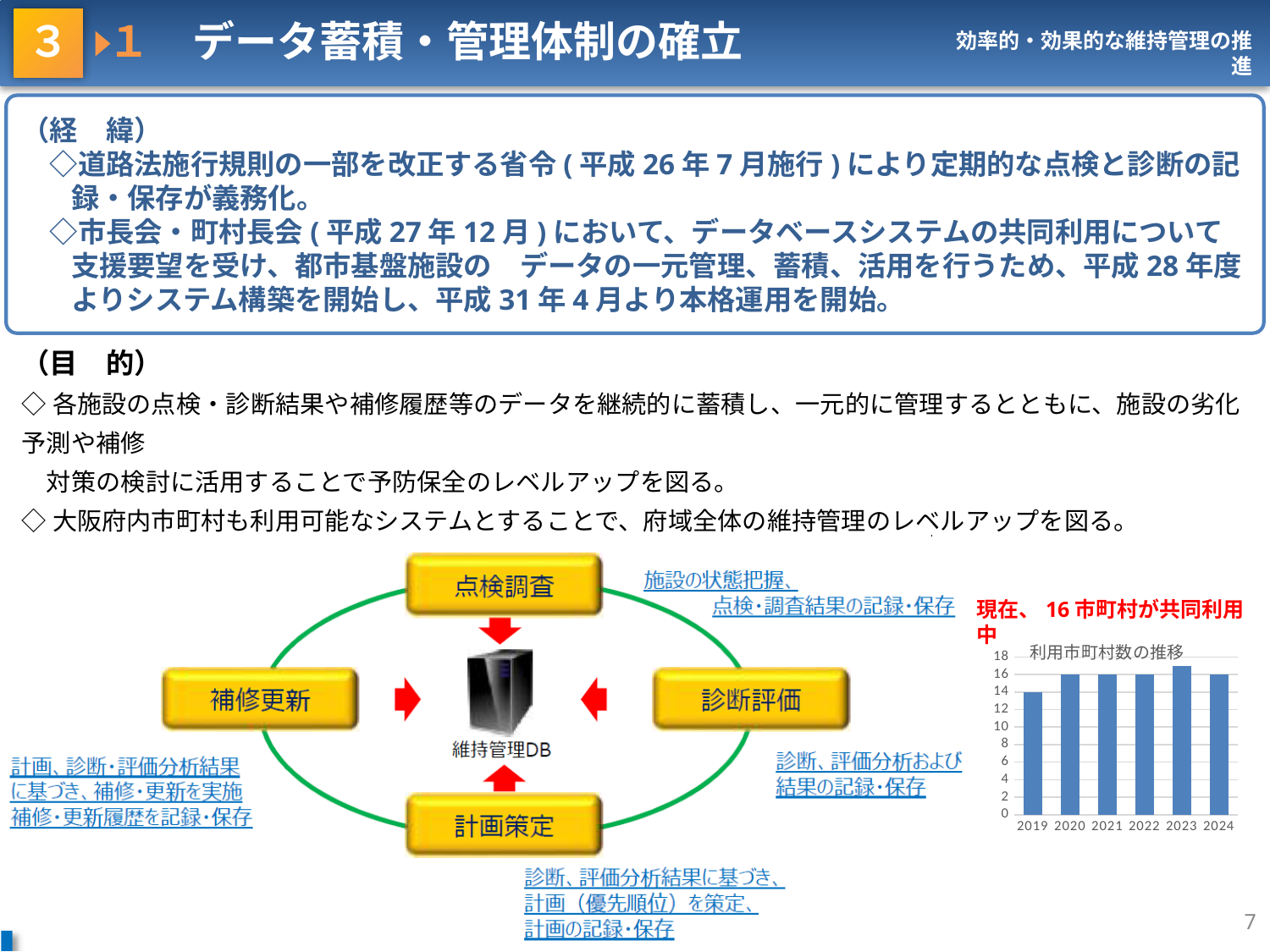
In the 利用市町村数の推移 chart, which is larger, the value for 2019 or the value for 2020? 2020 What is the highest value shown on the y axis of the 利用市町村数の推移 chart? 18 In the 利用市町村数の推移 chart, what is the value for 2024? 16 In the 利用市町村数の推移 chart, is the value for 2023 greater or less than 10? greater In the 利用市町村数の推移 chart, what is the difference between the values for 2020 and 2019? 2 In the 利用市町村数の推移 chart, does the value rise or fall from 2019 to 2020? rise In the 利用市町村数の推移 chart, which year has the lowest value? 2019 What kind of chart is the 利用市町村数の推移 chart? bar chart In the 利用市町村数の推移 chart, what is the value for 2020? 16 How many years are shown on the x axis of the 利用市町村数の推移 chart? 6 In the 利用市町村数の推移 chart, what is the value for 2019? 14 What is the title of the chart at the bottom right of the slide? 利用市町村数の推移